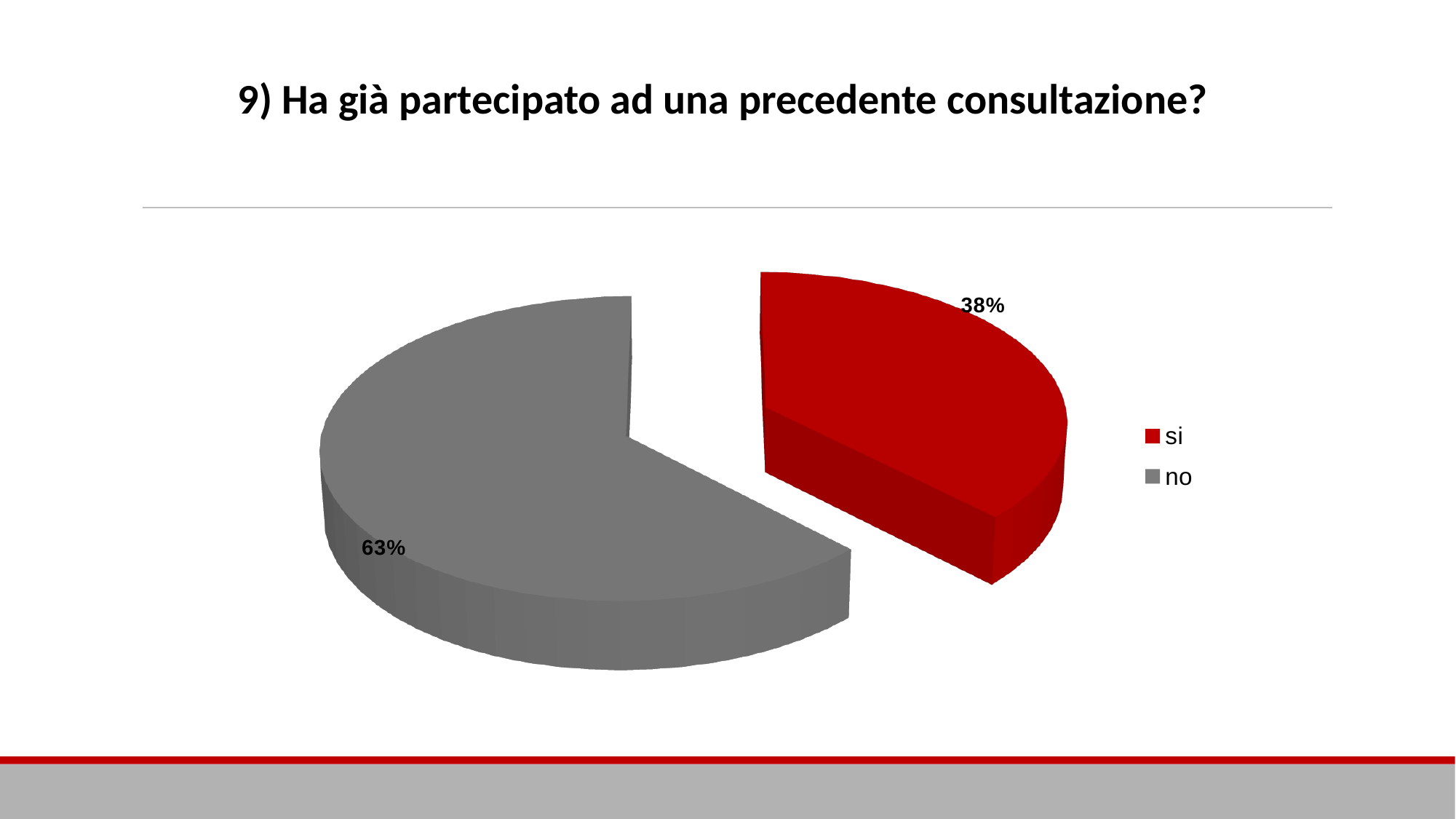
What is the title of the chart? 9) Ha già partecipato ad una precedente consultazione? What kind of chart is shown on the slide? pie chart What colour is the "si" slice? red Which category has the largest share of the pie? no How many categories does the pie chart show? 2 Which slice is larger, "si" or "no"? no What share of the pie does the "si" slice represent? 38% What percentage of respondents answered "si"? 38% What is the difference in percentage points between the "no" and "si" slices? 25 How many entries does the legend list? 2 Which category has the smallest share of the pie? si What percentage of respondents answered "no"? 63%